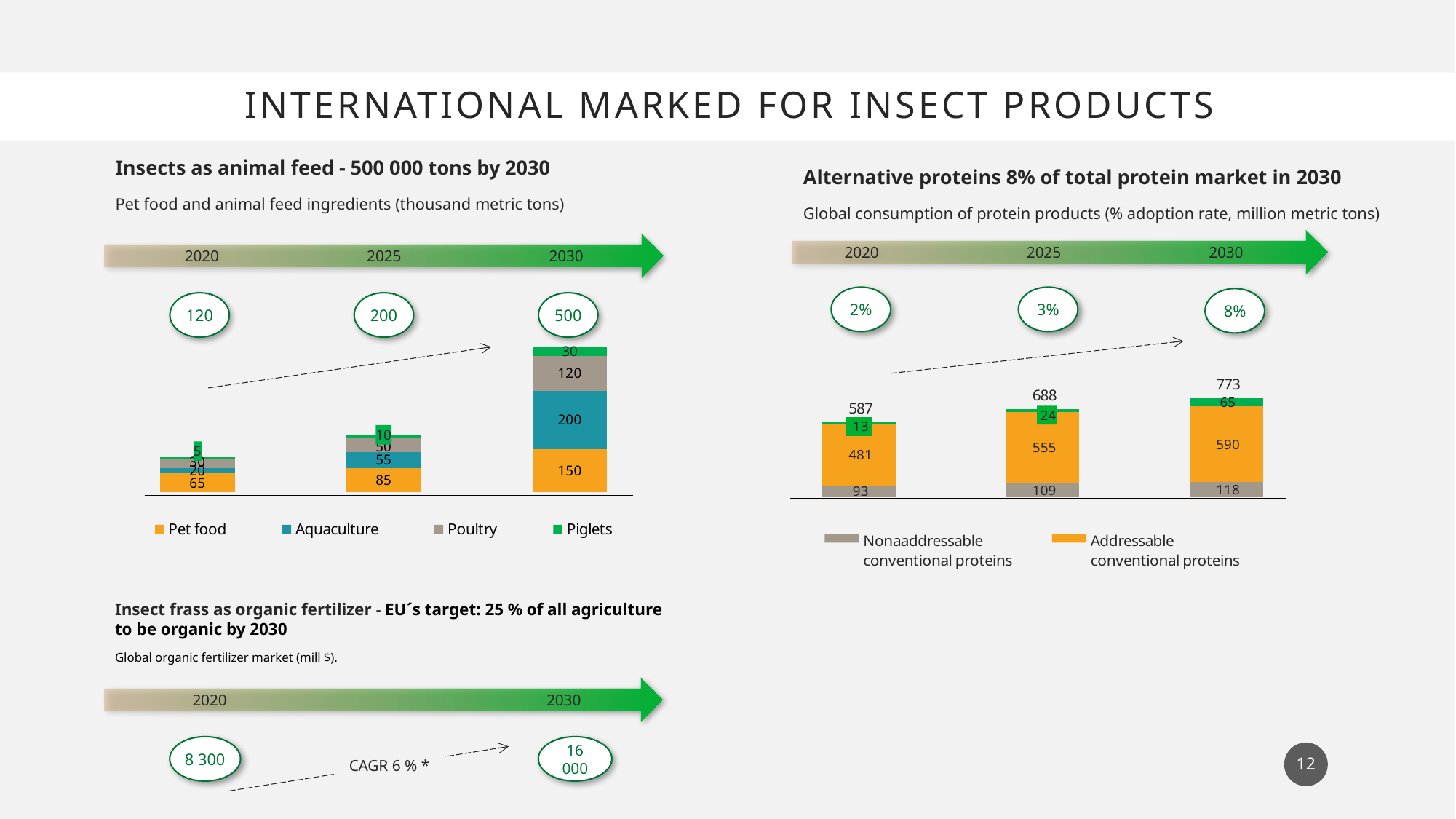
In the 'Alternative proteins' chart, do the bar totals rise or fall from 2020 to 2030? Rise In the 'Insects as animal feed' chart, what is the total of the stacked bar for 2020? 120 In the 'Insects as animal feed' chart, what is the Aquaculture value for 2025? 55 In the 'Alternative proteins' chart, which is larger: the Addressable conventional proteins value for 2020 or for 2030? 2030 In the 'Insects as animal feed' chart, what is the difference between the Poultry values for 2030 and 2025? 70 What kind of chart is the 'Insects as animal feed' chart? Stacked bar chart In the 'Alternative proteins' chart, what is the Nonaddressable conventional proteins value for 2030? 118 In the 'Insects as animal feed' chart, what is the Pet food value for 2030? 150 In the 'Alternative proteins' chart, what is the total shown above the 2020 bar? 587 In the 'Insects as animal feed' chart, which segment is the largest in the 2030 bar? Aquaculture In the 'Alternative proteins' chart, what is the Addressable conventional proteins value for 2025? 555 How many series does the legend of the 'Insects as animal feed' chart list? 4